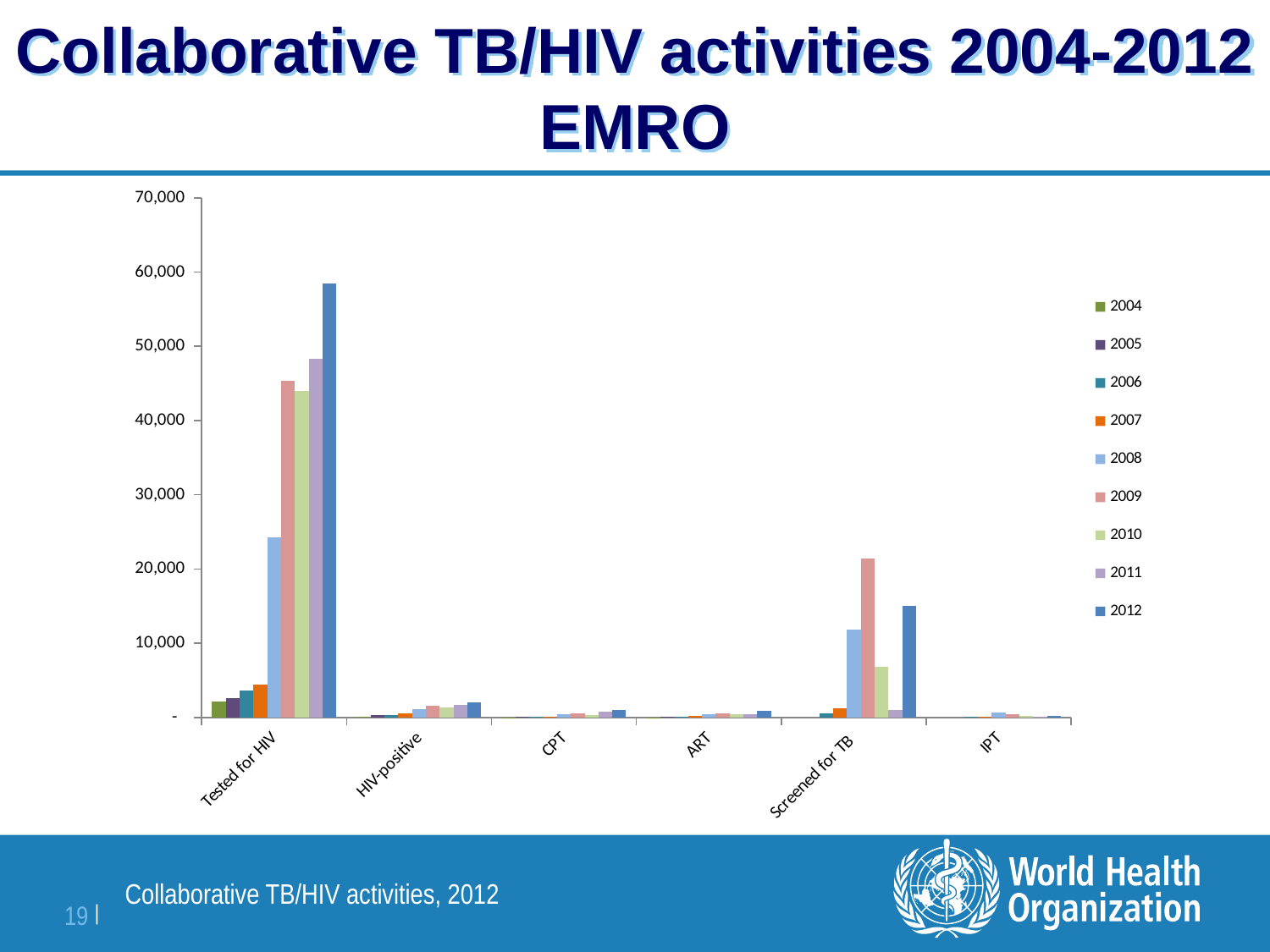
Is the 2008 value for Tested for HIV greater or less than 30,000? less Is the 2012 value for Tested for HIV greater or less than 50,000? greater What is the title of the slide containing the chart? Collaborative TB/HIV activities 2004-2012 EMRO How many series (years) does the legend list? 9 Is the 2009 value for Screened for TB greater or less than 10,000? greater How many activity categories are shown on the x axis? 6 What kind of chart is shown on the slide? bar chart What is the highest value shown on the y axis? 70,000 For Screened for TB, which year has the larger value, 2009 or 2012? 2009 Which category has the tallest bars overall? Tested for HIV For Tested for HIV, which year has the larger value, 2008 or 2012? 2012